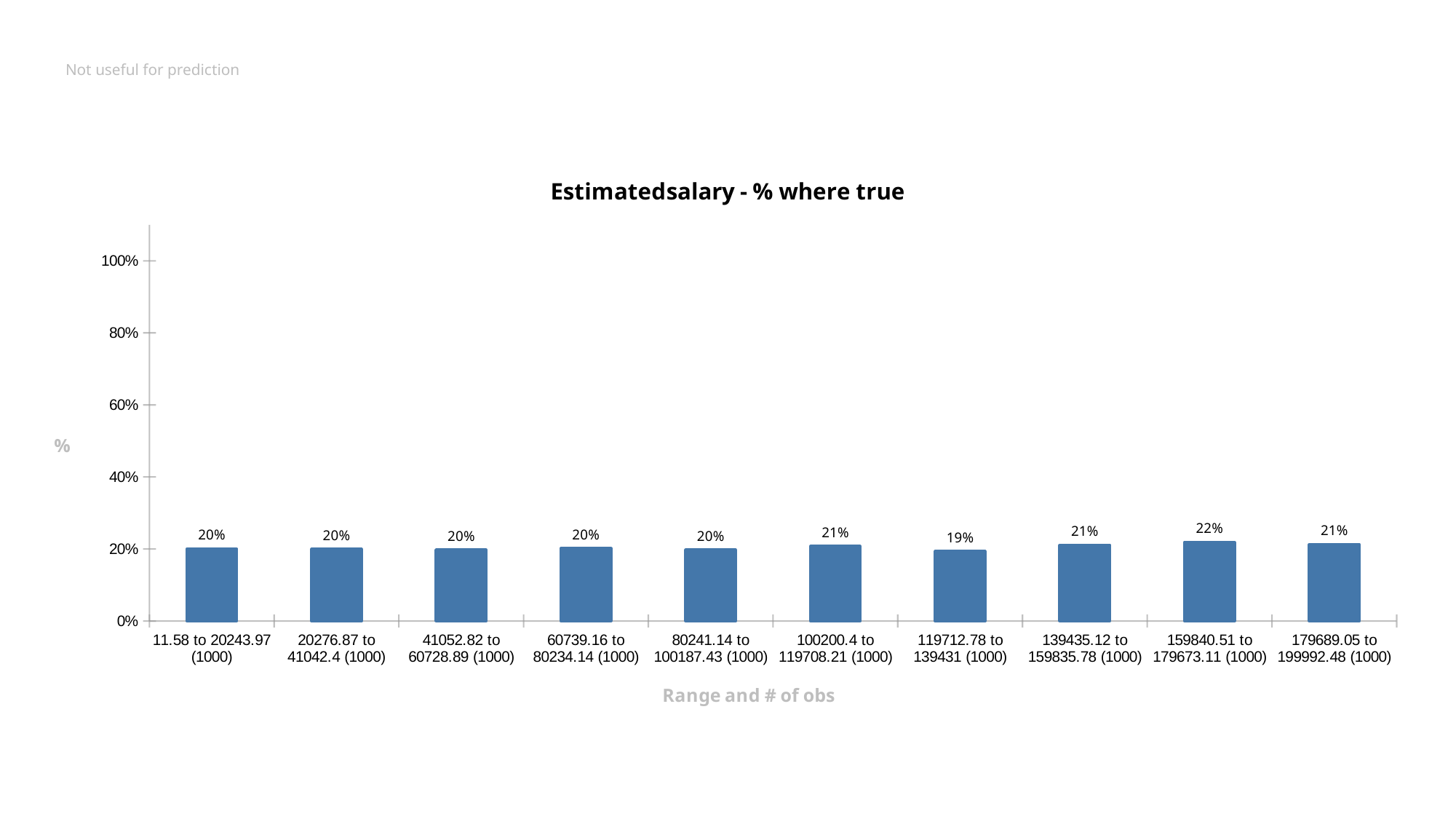
What is the value for the range 159840.51 to 179673.11 (1000)? 22% Which salary range has the highest % where true? 159840.51 to 179673.11 (1000) What is the label of the x axis? Range and # of obs What is the value for the range 11.58 to 20243.97 (1000)? 20% Which salary range has the lowest % where true? 119712.78 to 139431 (1000) How many salary range categories are plotted in the chart? 10 What type of chart is shown on the slide? bar chart What is the value for the range 100200.4 to 119708.21 (1000)? 21% What is the title of the chart? Estimatedsalary - % where true Is the value for 80241.14 to 100187.43 (1000) greater or less than 40%? less What is the value for the range 119712.78 to 139431 (1000)? 19% What is the difference between the values for 159840.51 to 179673.11 (1000) and 119712.78 to 139431 (1000)? 3%